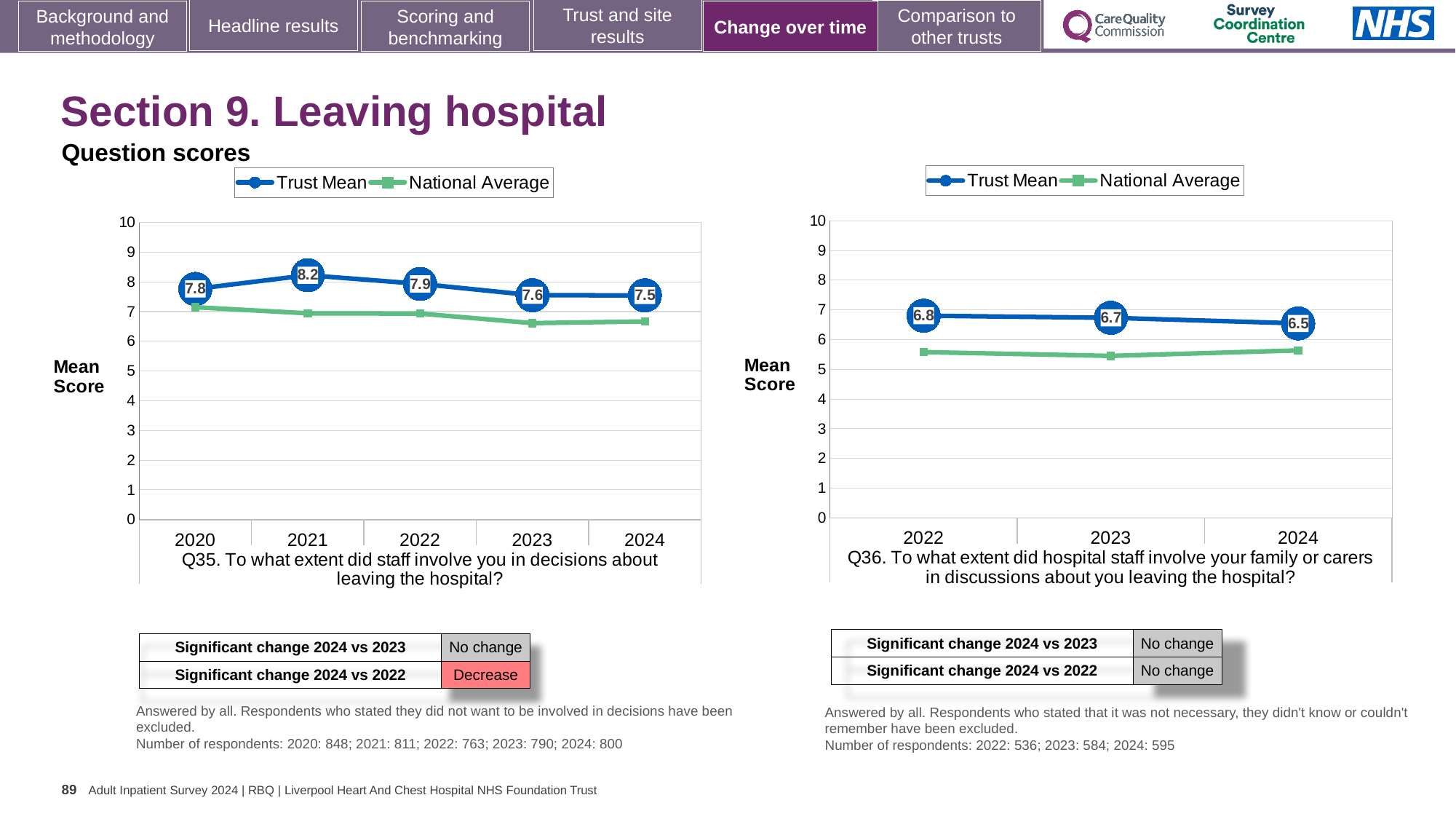
In the Q36 chart on the right, how many series does the legend list? 2 In the Q35 chart on the left, what is the Trust Mean score for 2024? 7.5 In the Q35 chart on the left, what is the Trust Mean score for 2021? 8.2 In the Q36 chart on the right, which is larger, the Trust Mean for 2023 or the Trust Mean for 2024? 2023 In the Q35 chart on the left, what is the difference between the Trust Mean scores for 2021 and 2024? 0.7 In the Q35 chart on the left, which year has the highest Trust Mean score? 2021 What kind of chart is the Q36 chart on the right? line chart In the Q35 chart on the left, which year has the lowest Trust Mean score? 2024 In the Q35 chart on the left, is the National Average for 2024 greater or less than 7? less In the Q36 chart on the right, does the Trust Mean rise or fall from 2022 to 2024? fall In the Q36 chart on the right, what is the Trust Mean score for 2022? 6.8 In the Q35 chart on the left, how many years are plotted on the x axis? 5